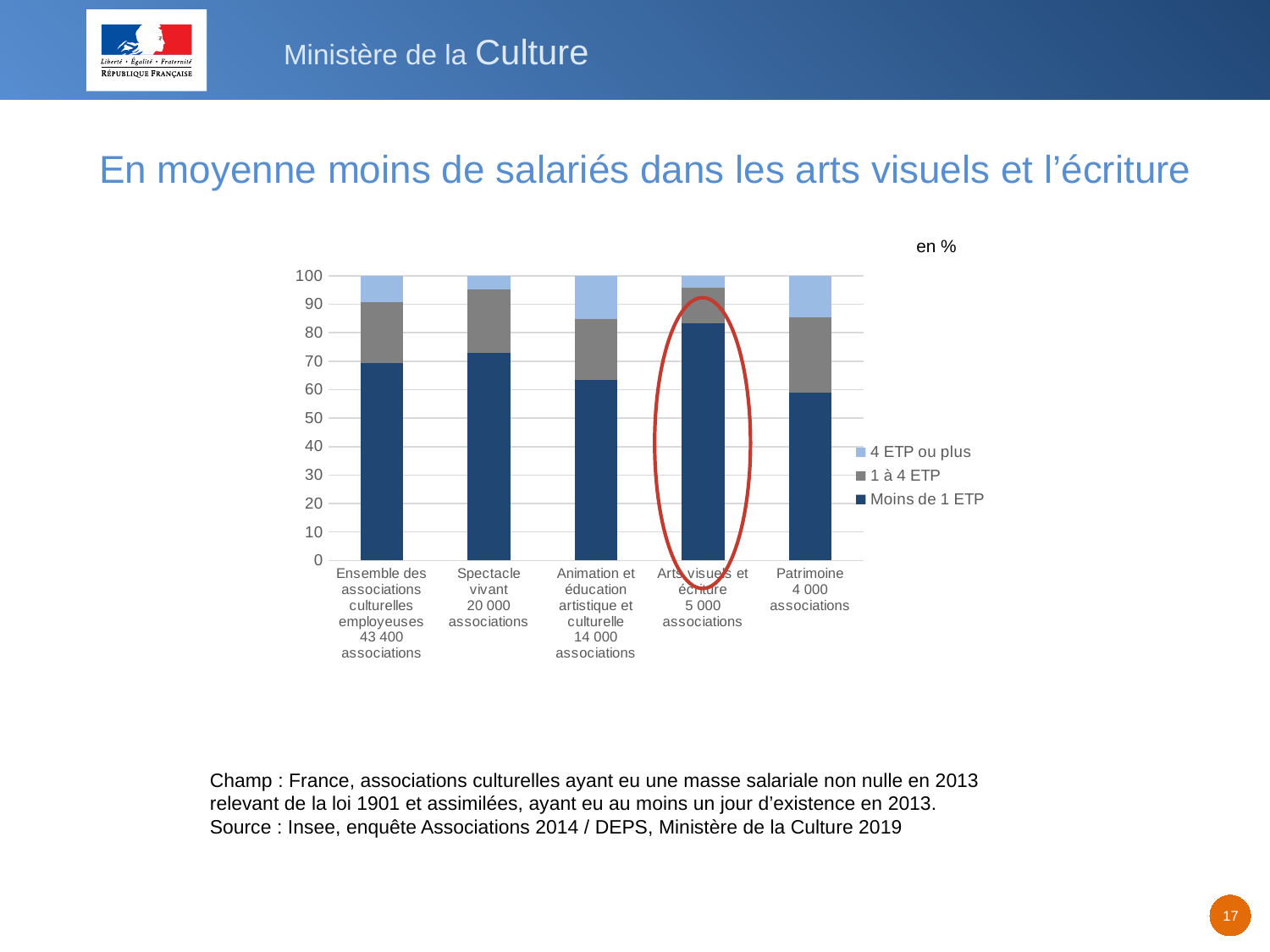
Is the value for Moins de 1 ETP in Spectacle vivant greater or less than 70? greater How many categories (bars) does the chart show? 5 Is the value for Moins de 1 ETP in Arts visuels et écriture greater or less than 80? greater Is the value for Moins de 1 ETP in Patrimoine greater or less than 70? less What unit is indicated above the chart? en % Which is larger for Moins de 1 ETP: Spectacle vivant or Patrimoine? Spectacle vivant What kind of chart is shown on the slide? stacked bar chart What are the three series listed in the legend? 4 ETP ou plus, 1 à 4 ETP, Moins de 1 ETP What is the total height of the stacked bar for Spectacle vivant? 100 Which is larger for 4 ETP ou plus: Patrimoine or Spectacle vivant? Patrimoine Which category has the highest value for Moins de 1 ETP? Arts visuels et écriture How many series does the legend list? 3